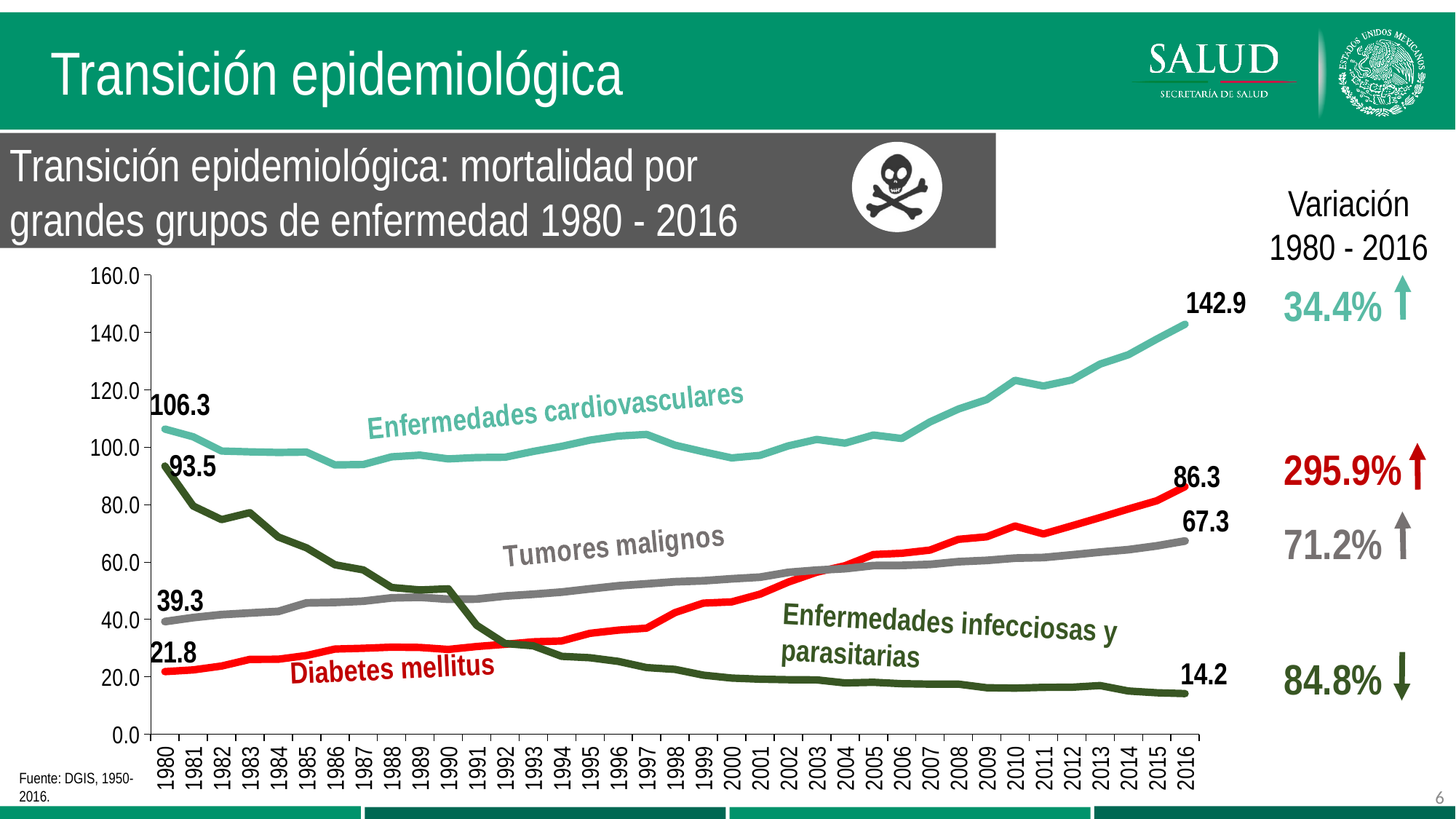
What is the value for Diabetes mellitus in 1980? 21.8 What is the value for Tumores malignos in 2016? 67.3 Does the value for Enfermedades infecciosas y parasitarias rise or fall from 1980 to 2016? fall Which disease group has the lowest value in 1980? Diabetes mellitus What is the value for Enfermedades cardiovasculares in 2016? 142.9 Is the value for Enfermedades cardiovasculares in 2000 greater or less than 100.0? less What is the value for Enfermedades infecciosas y parasitarias in 1980? 93.5 Which disease group has the highest value in 2016? Enfermedades cardiovasculares What is the difference between the 2016 and 1980 values for Diabetes mellitus? 64.5 What percentage variation from 1980 to 2016 is shown for Diabetes mellitus? 295.9% Which is larger in 2016: Diabetes mellitus or Tumores malignos? Diabetes mellitus What type of chart is shown on the slide? line chart